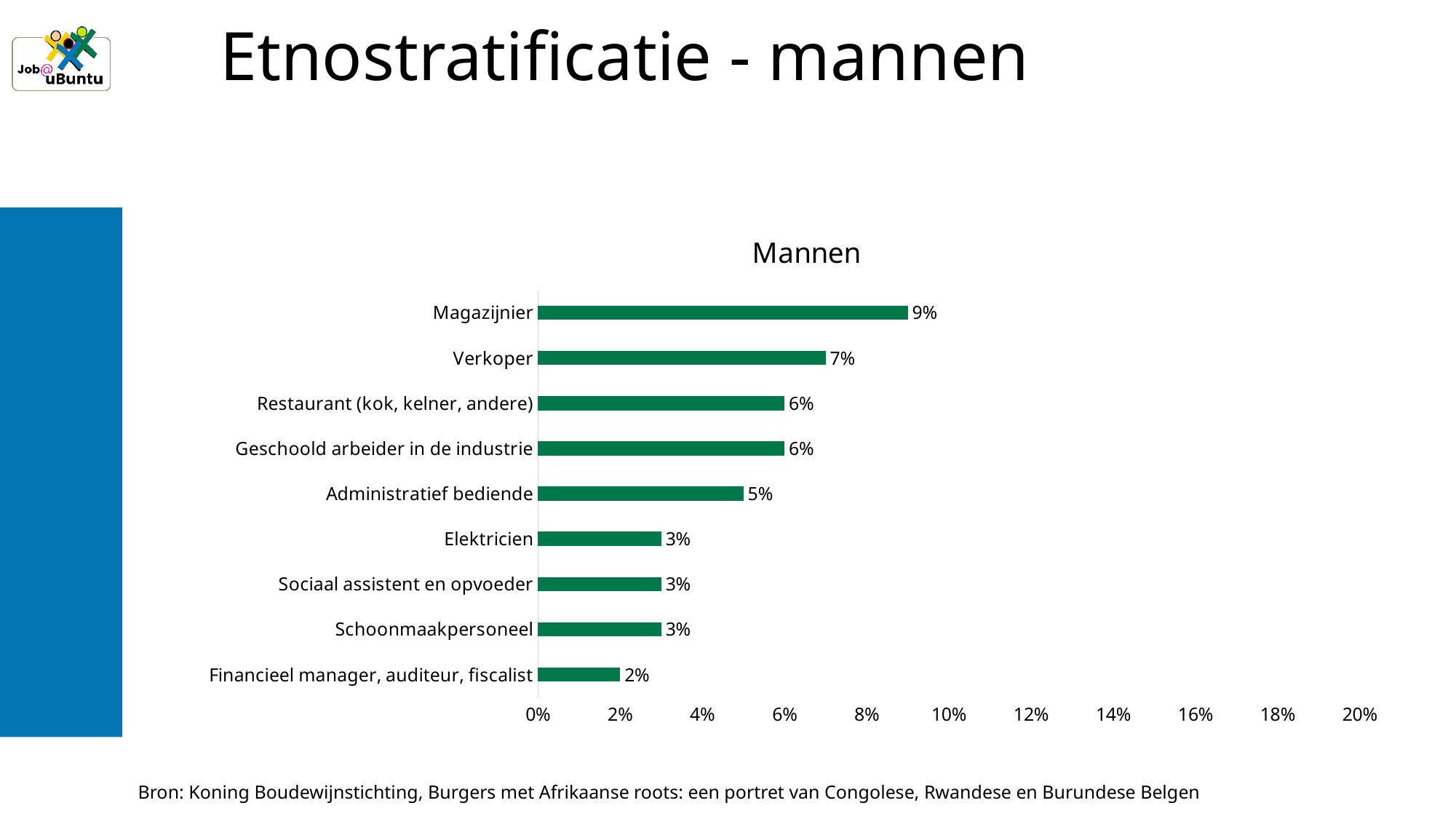
What is the value for Magazijnier? 9% Which category has the highest value? Magazijnier What is the value for Financieel manager, auditeur, fiscalist? 2% What is the value for Administratief bediende? 5% Is the value for Magazijnier greater or less than 10%? less How many categories are shown in the chart? 9 Which is larger, the value for Verkoper or the value for Elektricien? Verkoper Which category has the lowest value? Financieel manager, auditeur, fiscalist What is the title of the chart? Mannen What is the difference between the values for Verkoper and Financieel manager, auditeur, fiscalist? 5% What kind of chart is shown on the slide? bar chart What is the difference between the values for Magazijnier and Verkoper? 2%